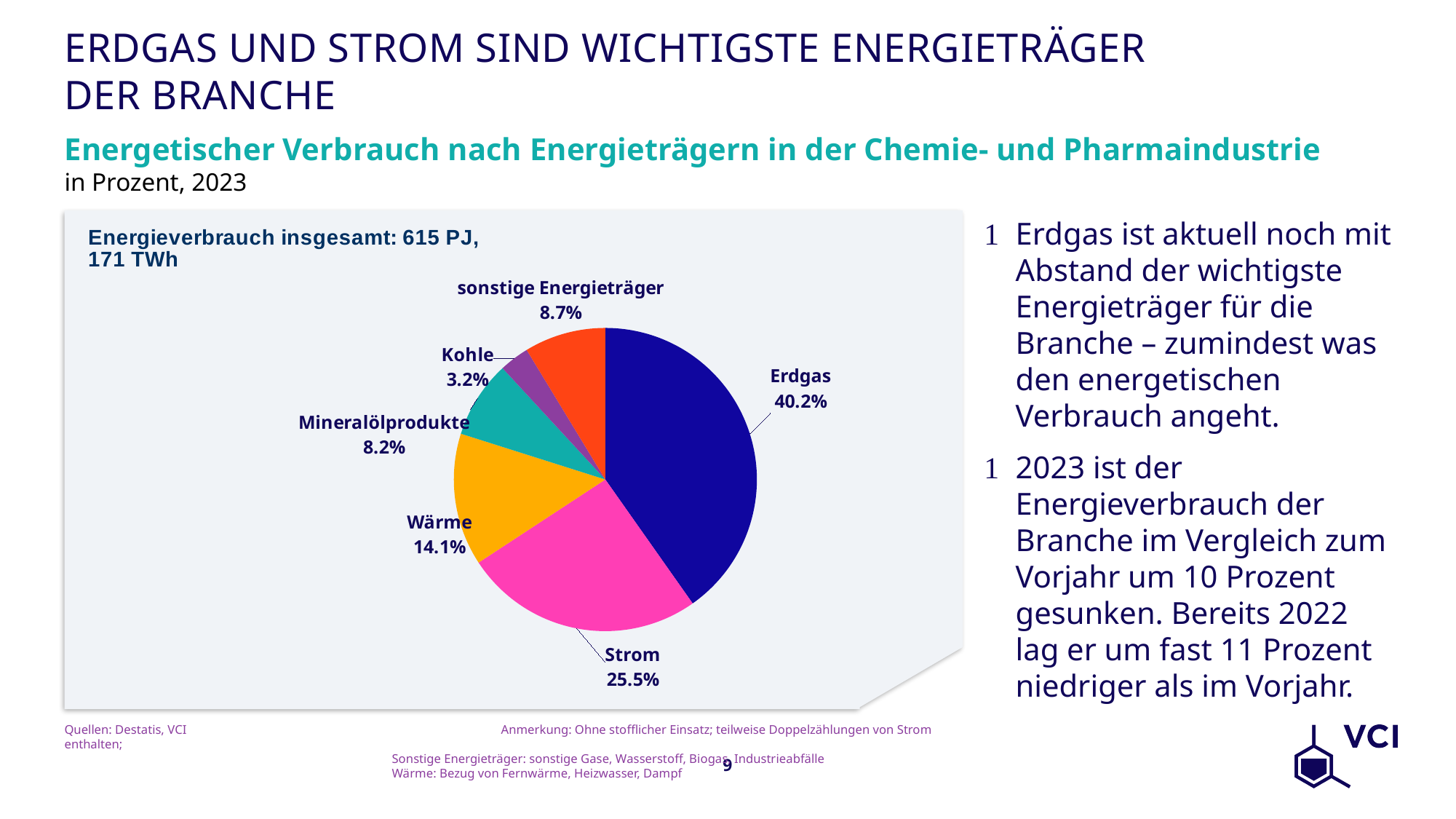
What is the difference in percentage points between the shares of Erdgas and Strom? 14.7 What colour is the Strom slice of the pie? Pink Which has a larger share, Mineralölprodukte or sonstige Energieträger? sonstige Energieträger What share of energy consumption does Erdgas account for? 40.2% What is the total energy consumption stated in the chart box, in PJ? 615 PJ Which energy source has the smallest share of the pie? Kohle What share of energy consumption does Kohle account for? 3.2% What share of energy consumption does Strom account for? 25.5% What share of energy consumption does Wärme account for? 14.1% Which energy source has the largest share of the pie? Erdgas What type of chart is shown on the slide? Pie chart How many categories are shown in the pie chart? 6